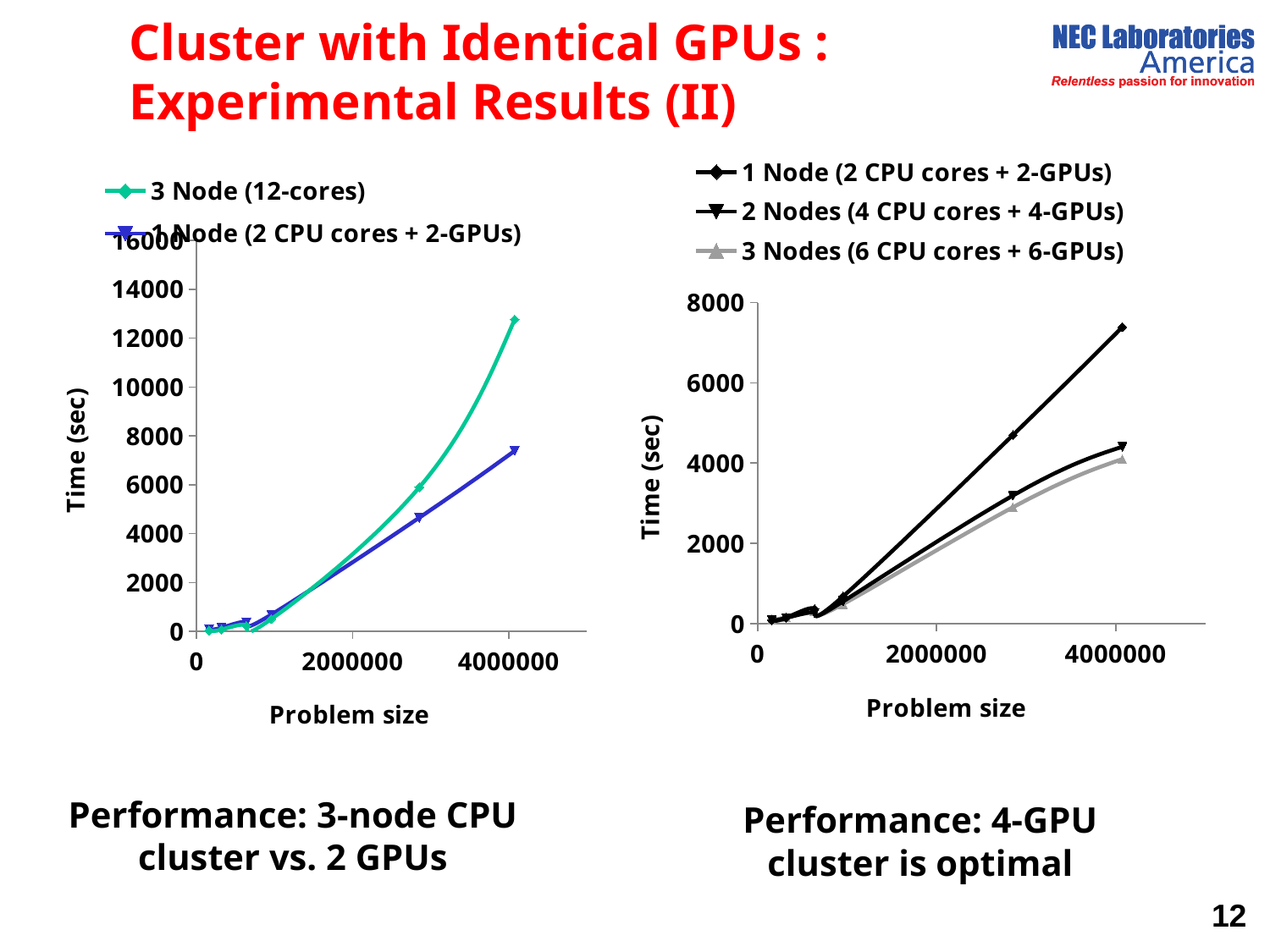
What kind of chart is the left chart (3 Node vs 1 Node)? line chart In the right chart, is the value for 3 Nodes (6 CPU cores + 6-GPUs) at the largest problem size greater or less than 6000? less In the right chart, is the value for 1 Node (2 CPU cores + 2-GPUs) at the largest problem size greater or less than 6000? greater In the right chart, which series has the highest time at the largest problem size? 1 Node (2 CPU cores + 2-GPUs) In the left chart, does the time for 3 Node (12-cores) rise or fall as problem size increases? rise In the left chart, which series has the higher time at the largest problem size, 3 Node (12-cores) or 1 Node (2 CPU cores + 2-GPUs)? 3 Node (12-cores) How many series does the legend of the left chart list? 2 In the left chart, is the value for 3 Node (12-cores) at the largest problem size greater or less than 12000? greater What kind of chart is the right chart (1, 2 and 3 Nodes with GPUs)? line chart What is the y-axis title of the right chart? Time (sec) How many series does the legend of the right chart list? 3